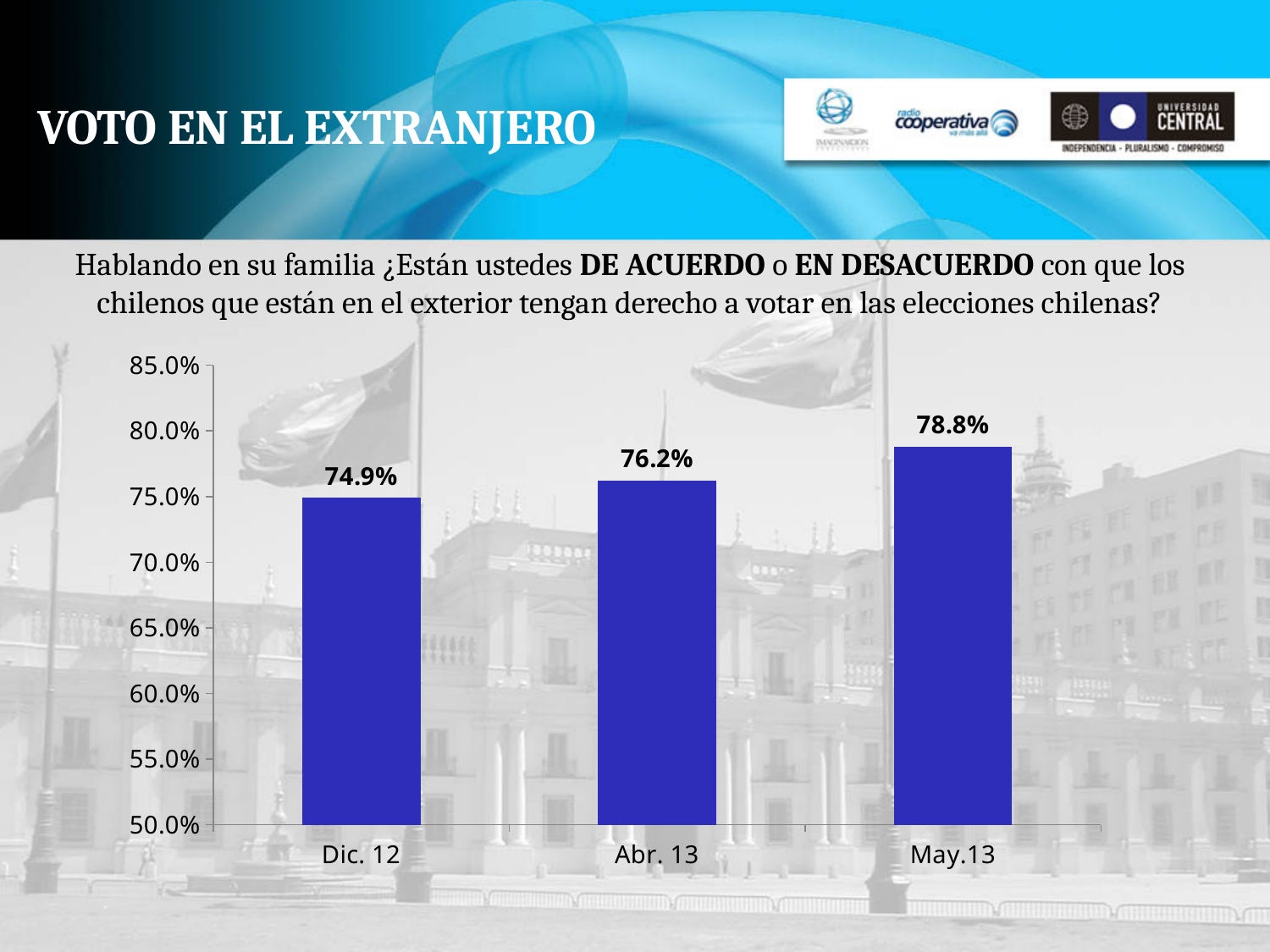
Do the values rise or fall from Dic. 12 to May.13? rise How many categories are shown on the x axis? 3 Which category has the lowest value? Dic. 12 Which is larger, the value for Abr. 13 or the value for May.13? May.13 What is the difference between the values for May.13 and Dic. 12? 3.9% What kind of chart is shown on the slide? bar chart Is the value for May.13 greater or less than 80.0%? less What is the value for Dic. 12? 74.9% What is the difference between the values for Abr. 13 and Dic. 12? 1.3% Which category has the highest value? May.13 What is the value for May.13? 78.8% What is the value for Abr. 13? 76.2%